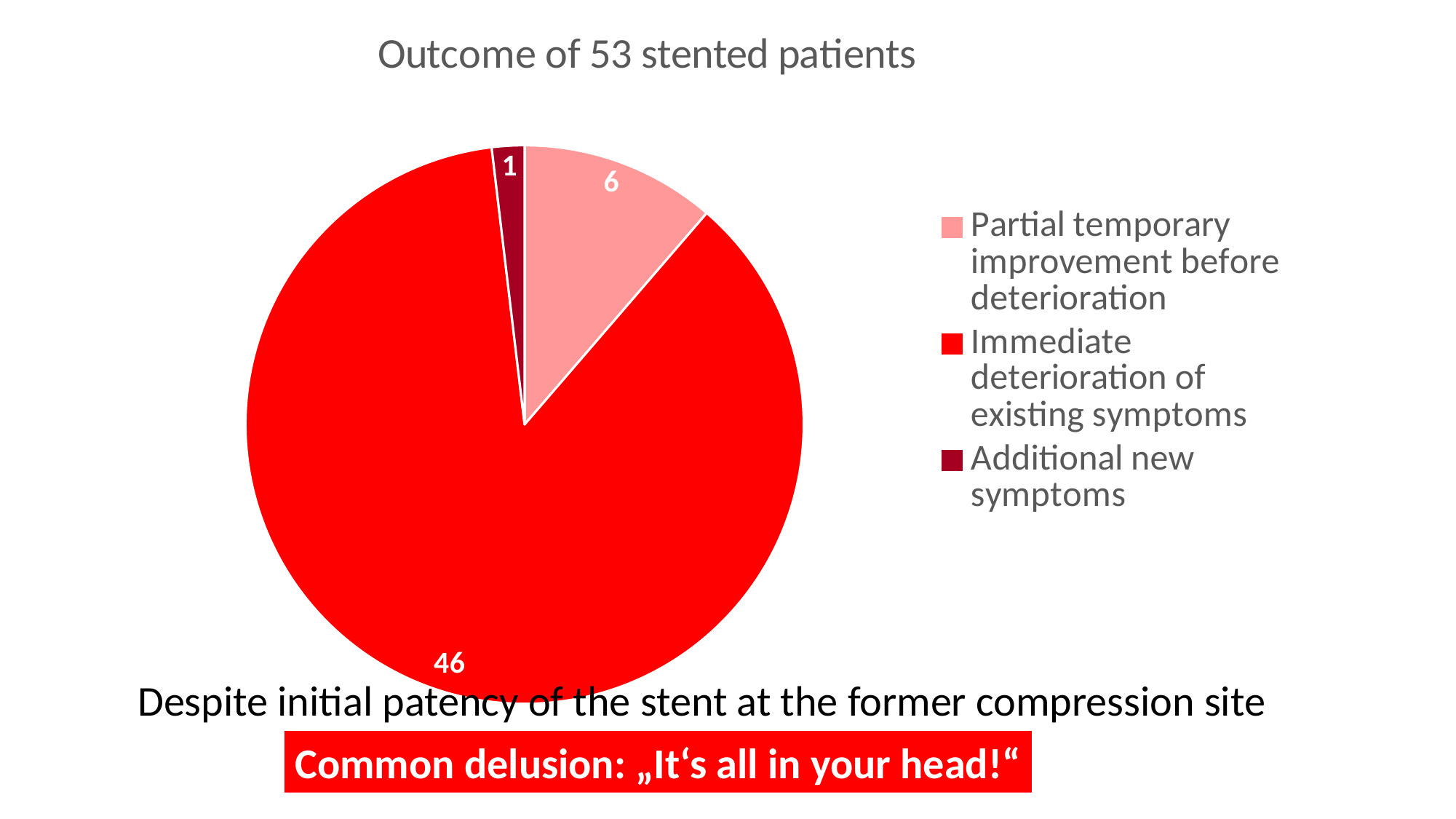
How many entries does the legend list? 3 Which is larger: 'Partial temporary improvement before deterioration' or 'Additional new symptoms'? Partial temporary improvement before deterioration What is the value for 'Immediate deterioration of existing symptoms'? 46 Which category has the largest slice? Immediate deterioration of existing symptoms How many slices does the pie chart have? 3 What is the total of all slices in the pie chart? 53 Which category has the smallest slice? Additional new symptoms What is the title of the chart? Outcome of 53 stented patients What kind of chart is shown on the slide? pie chart What is the value for 'Additional new symptoms'? 1 What is the difference between the values for 'Immediate deterioration of existing symptoms' and 'Partial temporary improvement before deterioration'? 40 What is the value for 'Partial temporary improvement before deterioration'? 6